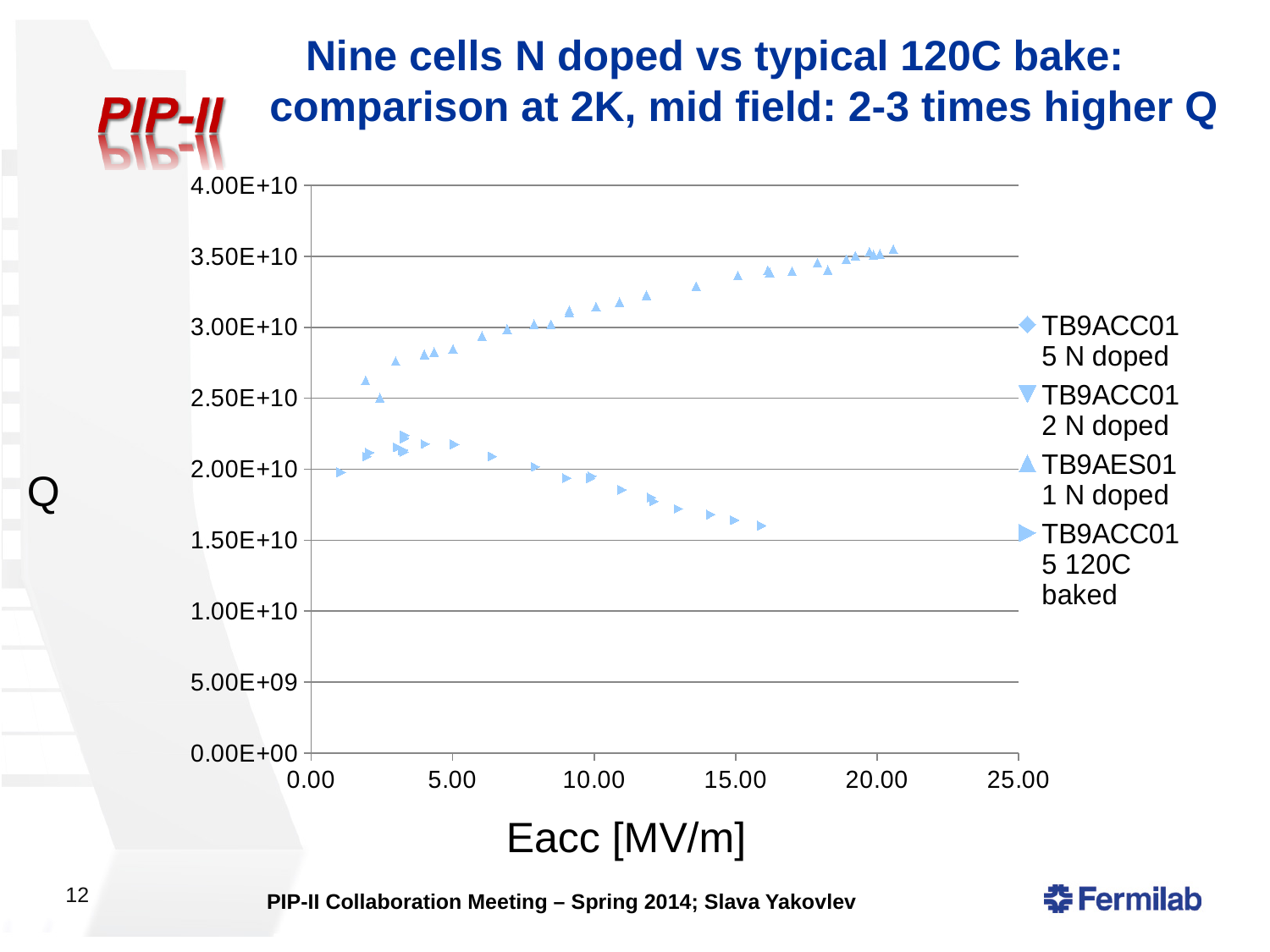
At Eacc of about 15 MV/m, is the Q value of the upper N doped series greater or less than 3.00E+10? greater Does the Q value of the TB9ACC015 120C baked series rise or fall as Eacc increases from 5 to 15 MV/m? fall What is the label of the y axis of the chart? Q How many series does the chart legend list? 4 At Eacc of about 15 MV/m, is the Q value of the TB9ACC015 120C baked series greater or less than 2.00E+10? less Does the Q value of the upper N doped series rise or fall as Eacc increases from 5 to 20 MV/m? rise At Eacc of about 10 MV/m, is the Q value of the TB9ACC015 120C baked series greater or less than 2.50E+10? less What is the highest value shown on the y axis of the chart? 4.00E+10 What is the highest value shown on the x axis of the chart? 25.00 What kind of chart is shown on the slide? scatter chart At Eacc of about 10 MV/m, which has the higher Q: the upper N doped series or the TB9ACC015 120C baked series? the N doped series